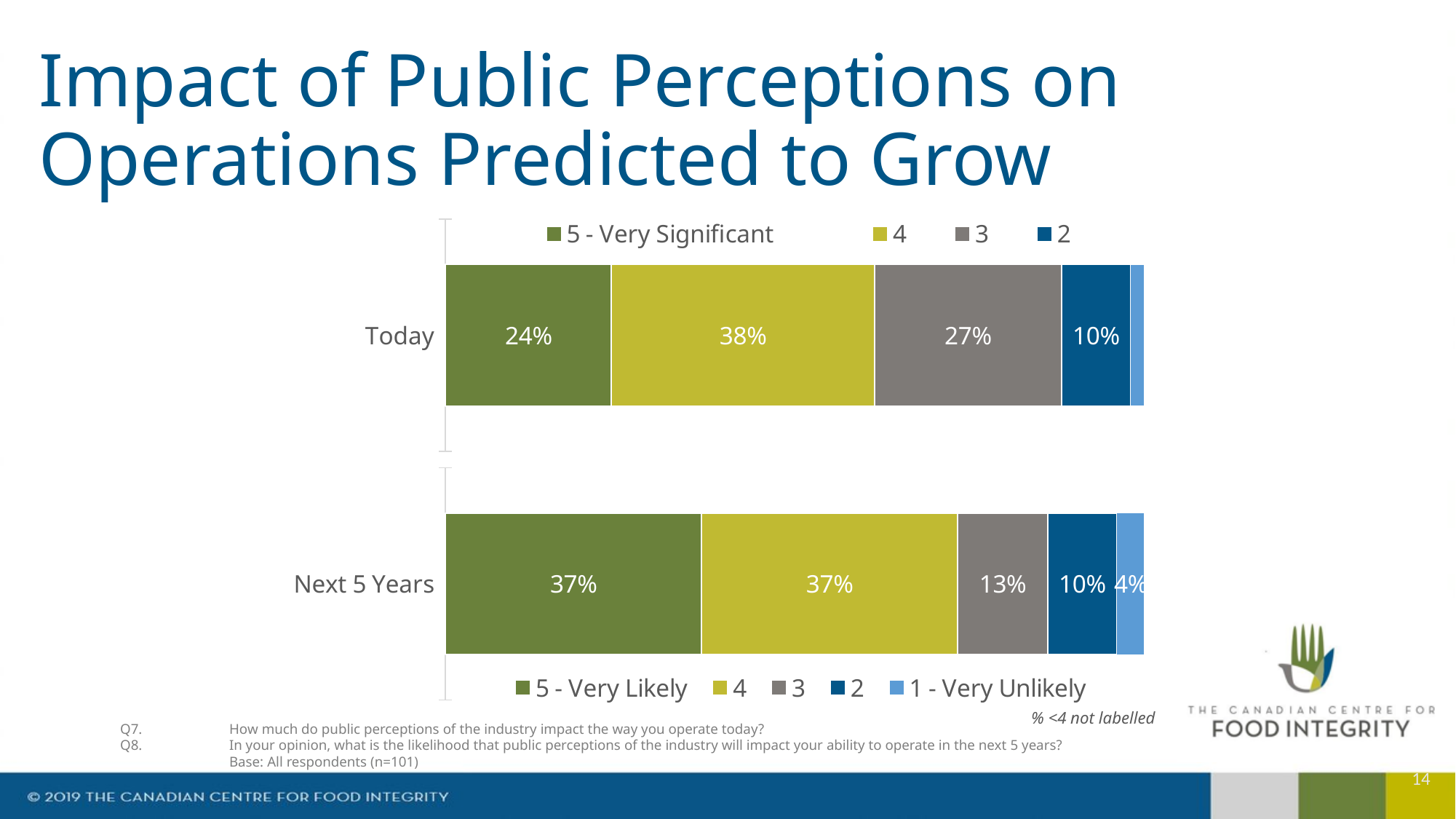
In the top chart (Today), what percentage is shown for the '4' segment? 38% In the bottom chart (Next 5 Years), what percentage is shown for the '5 - Very Likely' segment? 37% In the bottom chart (Next 5 Years), which labelled segment has the smallest percentage? 1 - Very Unlikely In the top chart (Today), what percentage is shown for the '5 - Very Significant' segment? 24% Which is larger: the '3' segment in the Today chart or the '3' segment in the Next 5 Years chart? Today What type of chart is used on this slide? Stacked bar chart In the bottom chart (Next 5 Years), what percentage is shown for the '3' segment? 13% How many series does the legend of the bottom chart (Next 5 Years) list? 5 What is the difference between the '5 - Very Likely' value in the Next 5 Years chart and the '5 - Very Significant' value in the Today chart? 13% In the bottom chart (Next 5 Years), what percentage is shown for the '1 - Very Unlikely' segment? 4% In the top chart (Today), what percentage is shown for the '3' segment? 27% In the top chart (Today), which labelled segment has the largest percentage? 4